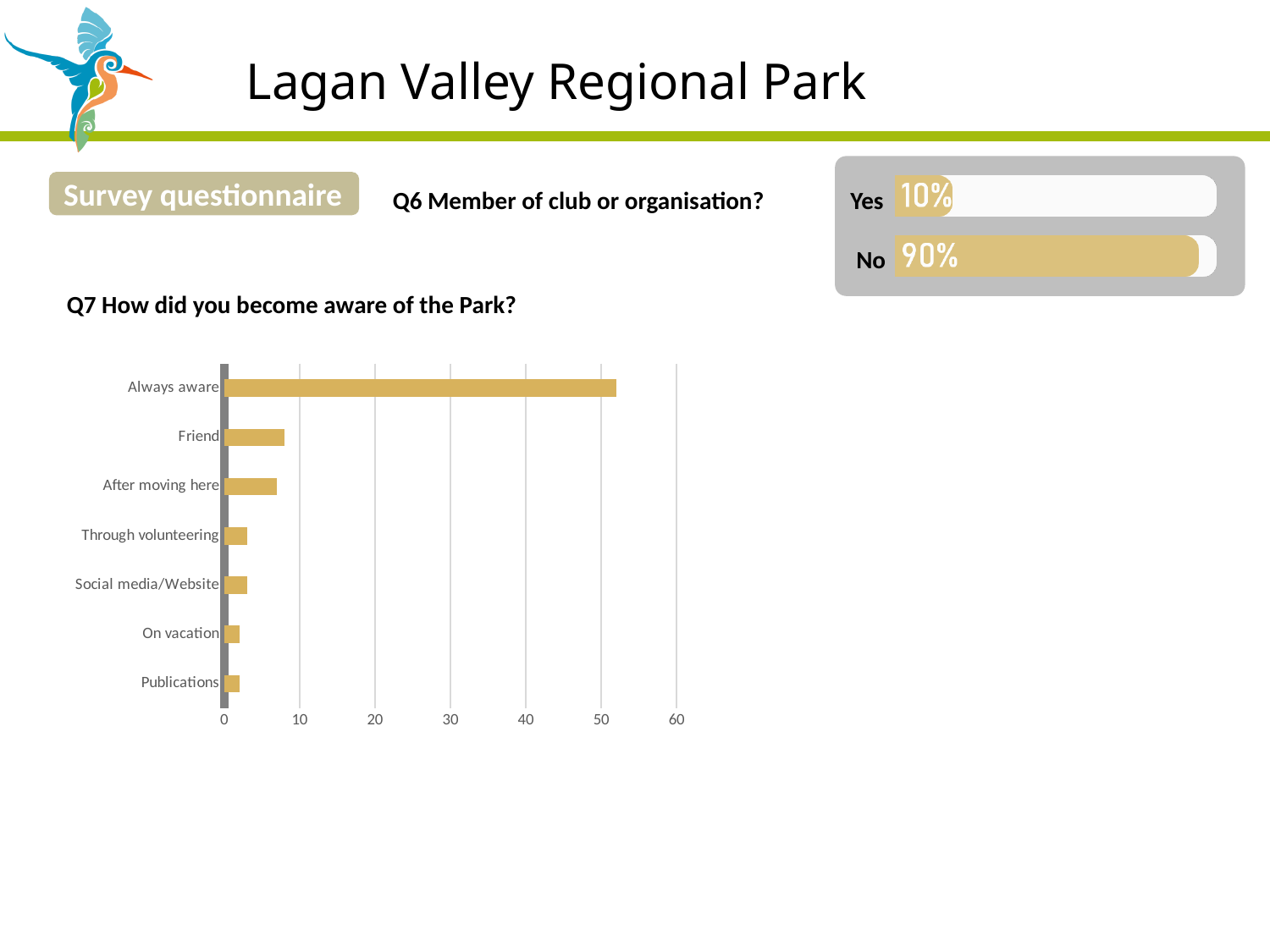
In the Q7 bar chart, is the value for 'Friend' greater or less than 10? less In the Q6 'Member of club or organisation?' graphic, what is the difference between the No and Yes percentages? 80% In the Q7 bar chart, which is larger: 'Always aware' or 'Friend'? Always aware In the Q7 bar chart, is the value for 'Through volunteering' greater or less than 10? less What is the highest tick value shown on the horizontal axis of the Q7 bar chart? 60 In the Q7 bar chart, which is larger: 'Friend' or 'Social media/Website'? Friend How many categories are shown in the Q7 bar chart? 7 In the Q6 'Member of club or organisation?' graphic, what percentage answered No? 90% In the Q7 bar chart, is the value for 'Always aware' greater or less than 40? greater In the Q7 bar chart, do the values rise or fall going from the top category to the bottom category? fall What kind of chart is used for Q7 'How did you become aware of the Park?' bar chart In the Q7 bar chart, which category has the highest value? Always aware